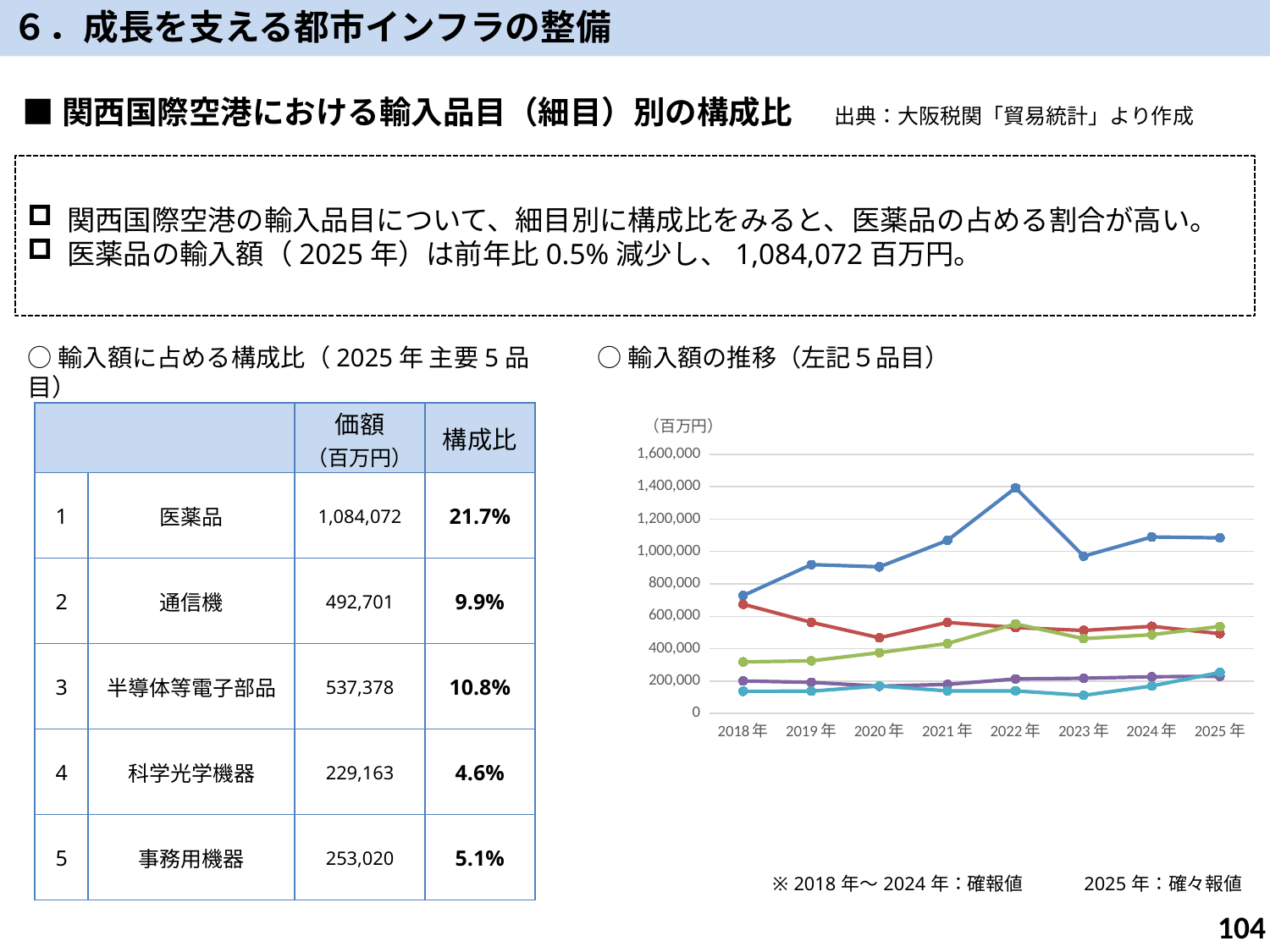
In the line chart, in which year does the blue line reach its highest point? 2022年 In the line chart, in which year is the blue line at its lowest point? 2018年 How many lines are plotted in the line chart? 5 Does the blue line rise or fall from 2018年 to 2022年? rise How many years are plotted along the x axis of the line chart? 8 Is the value of the light-blue line in 2023年 greater or less than 200,000? less Is the value of the blue line in 2018年 greater or less than 800,000? less Is the value of the green line in 2018年 greater or less than 400,000? less What kind of chart is shown under 「輸入額の推移（左記5品目）」? line chart What unit is shown above the y axis of the line chart? （百万円） In 2019年, which line has the larger value in the line chart, the blue line or the red line? the blue line